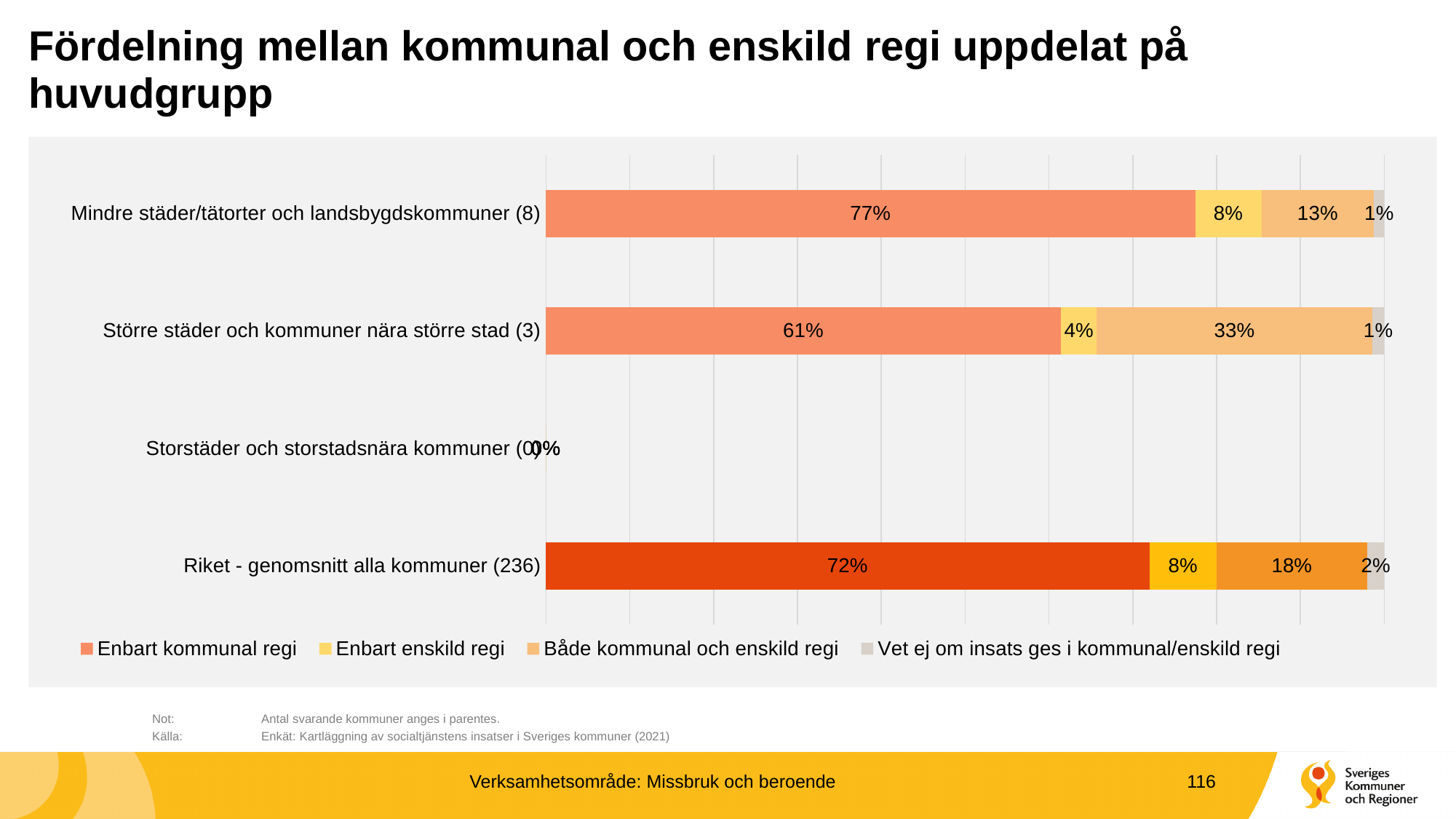
What is the difference between the 'Enbart kommunal regi' values for 'Mindre städer/tätorter och landsbygdskommuner (8)' and 'Större städer och kommuner nära större stad (3)'? 16 percentage points Which category has the highest value for 'Både kommunal och enskild regi'? Större städer och kommuner nära större stad (3) What is the value for 'Enbart enskild regi' for 'Riket - genomsnitt alla kommuner (236)'? 8% What is the value for 'Vet ej om insats ges i kommunal/enskild regi' for 'Riket - genomsnitt alla kommuner (236)'? 2% Which category has the highest value for 'Enbart kommunal regi'? Mindre städer/tätorter och landsbygdskommuner (8) How many categories are shown on the y axis of the chart? 4 What is the value for 'Enbart kommunal regi' for 'Mindre städer/tätorter och landsbygdskommuner (8)'? 77% What value is shown for 'Storstäder och storstadsnära kommuner (0)'? 0% How many series does the legend list? 4 Which is larger: the 'Både kommunal och enskild regi' value for 'Riket - genomsnitt alla kommuner (236)' or for 'Mindre städer/tätorter och landsbygdskommuner (8)'? Riket - genomsnitt alla kommuner (236) What is the value for 'Både kommunal och enskild regi' for 'Större städer och kommuner nära större stad (3)'? 33% What kind of chart is shown on the slide? Stacked bar chart